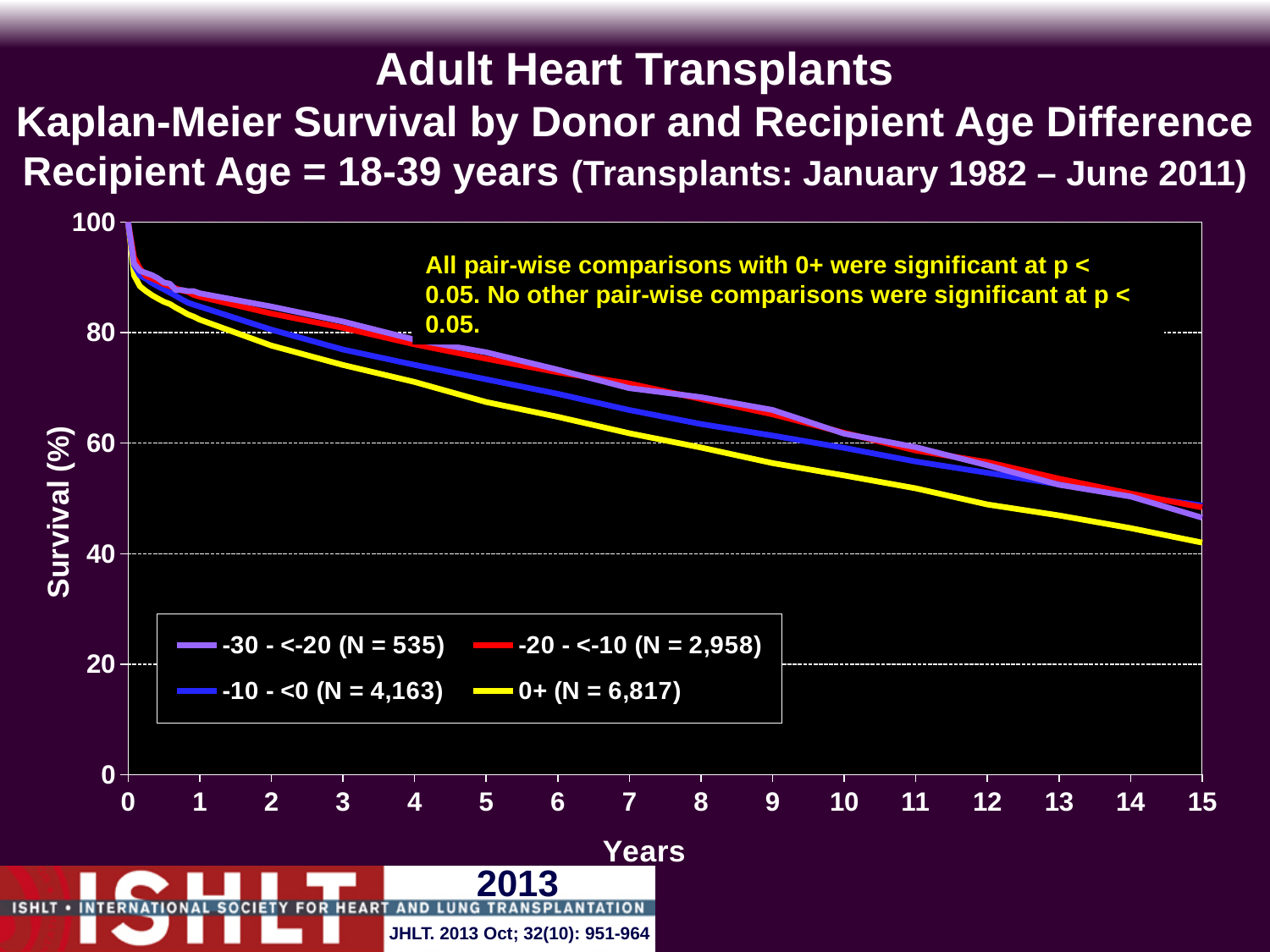
At 15 years, which group has higher survival: 0+ or -20 - <-10? -20 - <-10 Do the survival curves rise or fall as years increase? fall What is the N for the 0+ group in the legend? 6,817 What is the N for the -30 - <-20 group in the legend? 535 How many series does the legend list? 4 Which group has the largest N in the legend? 0+ (N = 6,817) Which group has the smallest N in the legend? -30 - <-20 (N = 535) What is the N for the -10 - <0 group in the legend? 4,163 Is the survival for the -10 - <0 group at 5 years greater or less than 60? greater What is the difference between the N for the 0+ group and the N for the -30 - <-20 group? 6,282 What kind of chart is shown on the slide? line chart Is the survival for the 0+ group at 15 years greater or less than 60? less